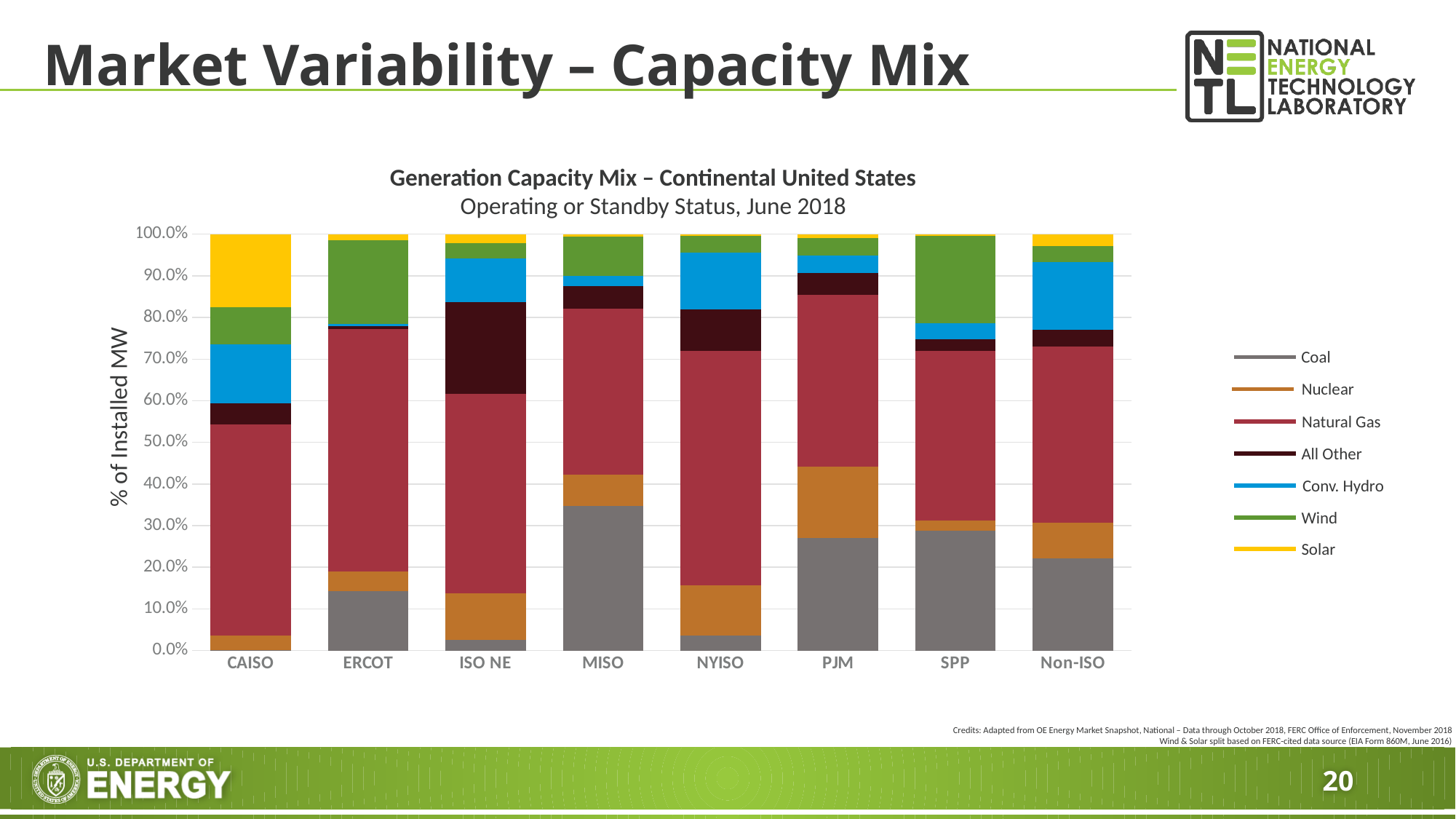
How many series does the legend list? 7 How many markets (categories) are shown along the x axis? 8 Which has a larger Coal share, MISO or PJM? MISO Which market has the largest Solar share of installed MW? CAISO What type of chart is shown on the slide? Stacked bar chart Which market has the largest Nuclear share of installed MW? PJM Which market has the largest Coal share of installed MW? MISO What is the label on the y axis? % of Installed MW Is the Coal share for MISO greater or less than 30.0%? greater Is the Coal share for PJM greater or less than 30.0%? less What is the title of the chart? Generation Capacity Mix – Continental United States